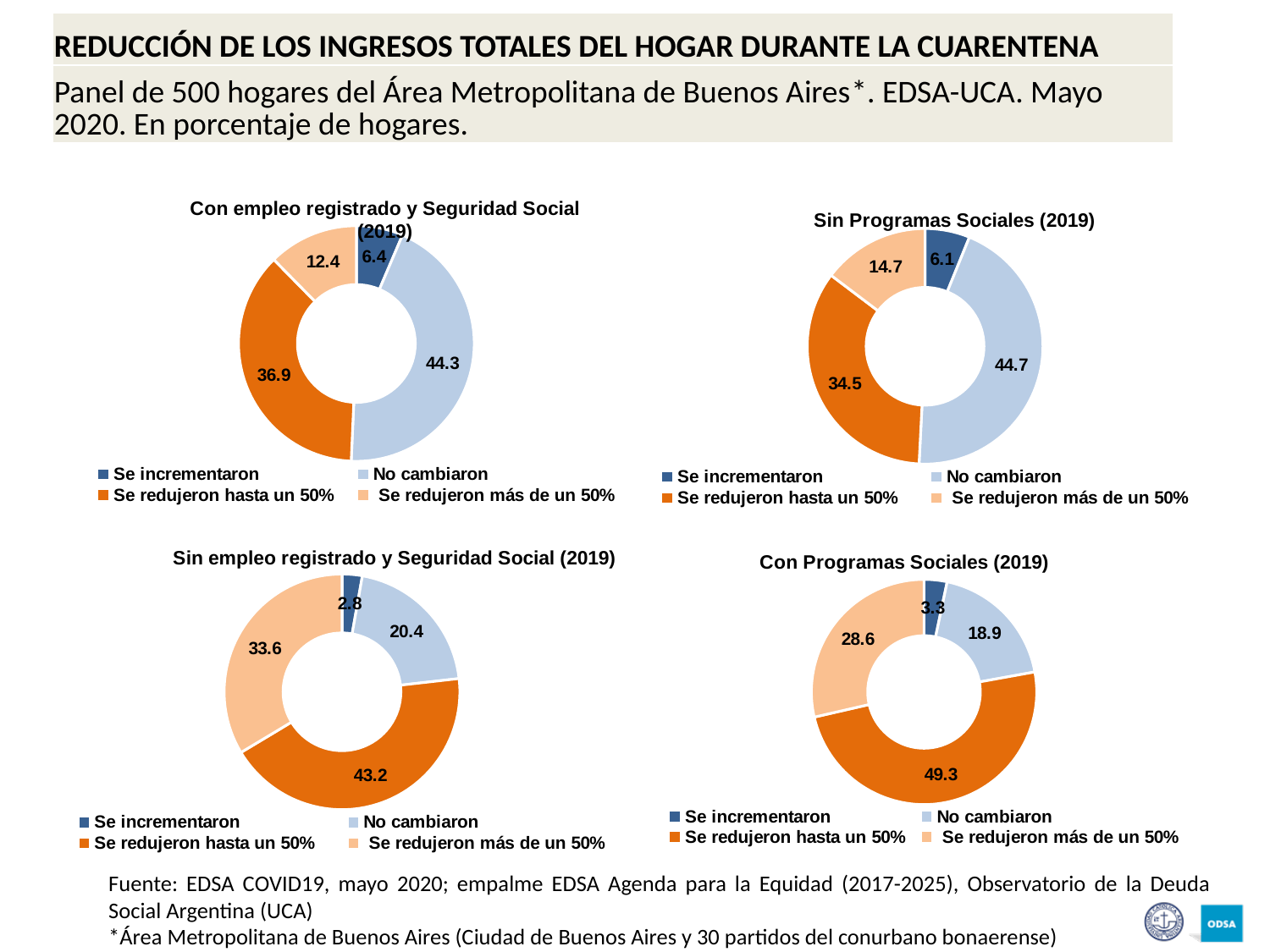
In the 'Con empleo registrado y Seguridad Social (2019)' chart, what is the value for 'No cambiaron'? 44.3 In the 'Con Programas Sociales (2019)' chart, what is the value for 'Se redujeron más de un 50%'? 28.6 In the 'Con empleo registrado y Seguridad Social (2019)' chart, which is larger: 'No cambiaron' or 'Se redujeron hasta un 50%'? No cambiaron How many categories does the 'Con Programas Sociales (2019)' chart show? 4 In the 'Sin empleo registrado y Seguridad Social (2019)' chart, what is the difference between 'Se redujeron hasta un 50%' and 'Se redujeron más de un 50%'? 9.6 How many charts are on the slide? 4 What kind of chart is the 'Sin Programas Sociales (2019)' chart? doughnut chart In the 'Sin Programas Sociales (2019)' chart, which category has the smallest share? Se incrementaron In the 'Sin Programas Sociales (2019)' chart, what is the value for 'Se redujeron hasta un 50%'? 34.5 In the 'Sin empleo registrado y Seguridad Social (2019)' chart, what is the value for 'Se incrementaron'? 2.8 In the 'Con Programas Sociales (2019)' chart, which category has the largest share? Se redujeron hasta un 50% In the 'Sin empleo registrado y Seguridad Social (2019)' chart, what is the value for 'No cambiaron'? 20.4